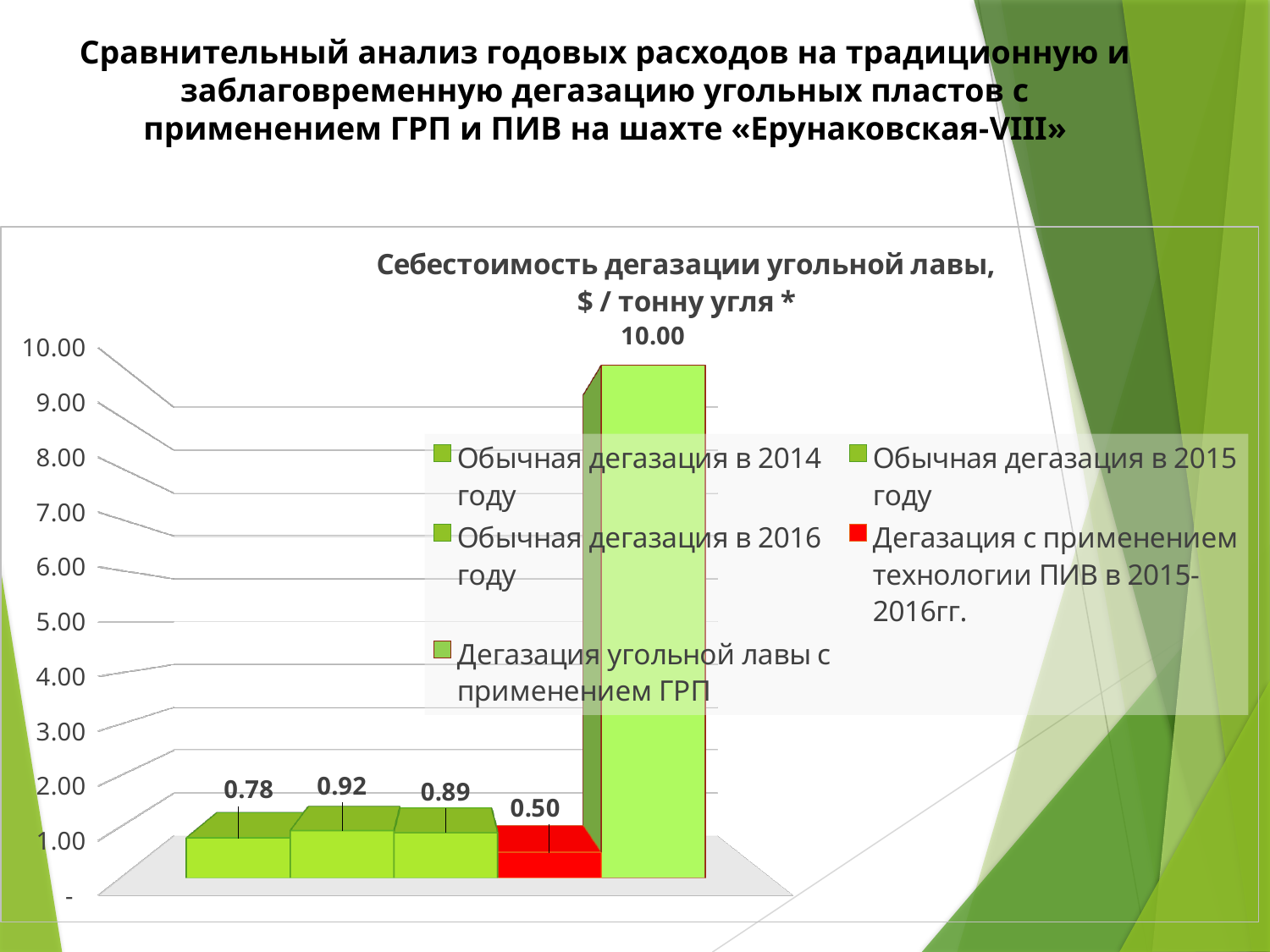
What is the value for 'Дегазация угольной лавы с применением ГРП'? 10.00 How many series does the legend list? 5 What is the title of the chart? Себестоимость дегазации угольной лавы, $ / тонну угля * Which series has the lowest value? Дегазация с применением технологии ПИВ в 2015-2016гг. Which series has the highest value? Дегазация угольной лавы с применением ГРП How many bars are plotted in the chart? 5 What is the value for 'Обычная дегазация в 2015 году'? 0.92 What is the difference between the value for 'Дегазация угольной лавы с применением ГРП' and the value for 'Дегазация с применением технологии ПИВ в 2015-2016гг.'? 9.50 What type of chart is shown on the slide? bar chart What is the value for 'Обычная дегазация в 2014 году'? 0.78 What is the value for 'Дегазация с применением технологии ПИВ в 2015-2016гг.'? 0.50 Which bar is coloured red? Дегазация с применением технологии ПИВ в 2015-2016гг.